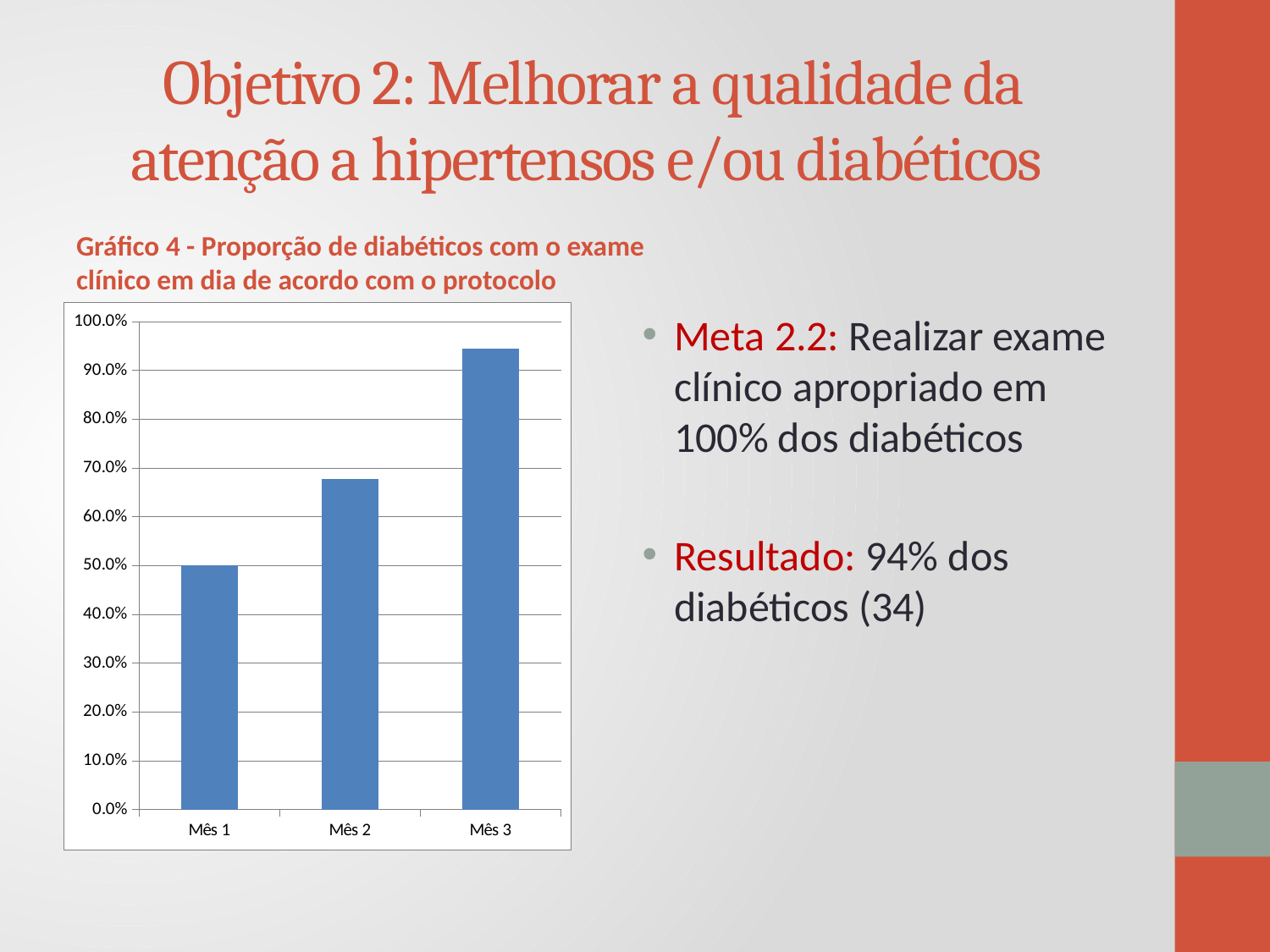
What type of chart is shown on the slide? bar chart Which is larger, the value for Mês 1 or the value for Mês 2? Mês 2 Is the value for Mês 3 greater or less than 90.0%? greater Do the values rise or fall from Mês 1 to Mês 3? rise Is the value for Mês 2 greater or less than 70.0%? less What is the title of the chart? Gráfico 4 - Proporção de diabéticos com o exame clínico em dia de acordo com o protocolo Which month has the lowest value on the chart? Mês 1 What colour are the bars in the chart? blue Is the value for Mês 2 greater or less than 60.0%? greater How many categories (months) are plotted on the chart? 3 Which month has the highest proportion of diabetics with the clinical exam up to date? Mês 3 What is the value for Mês 1? 50.0%